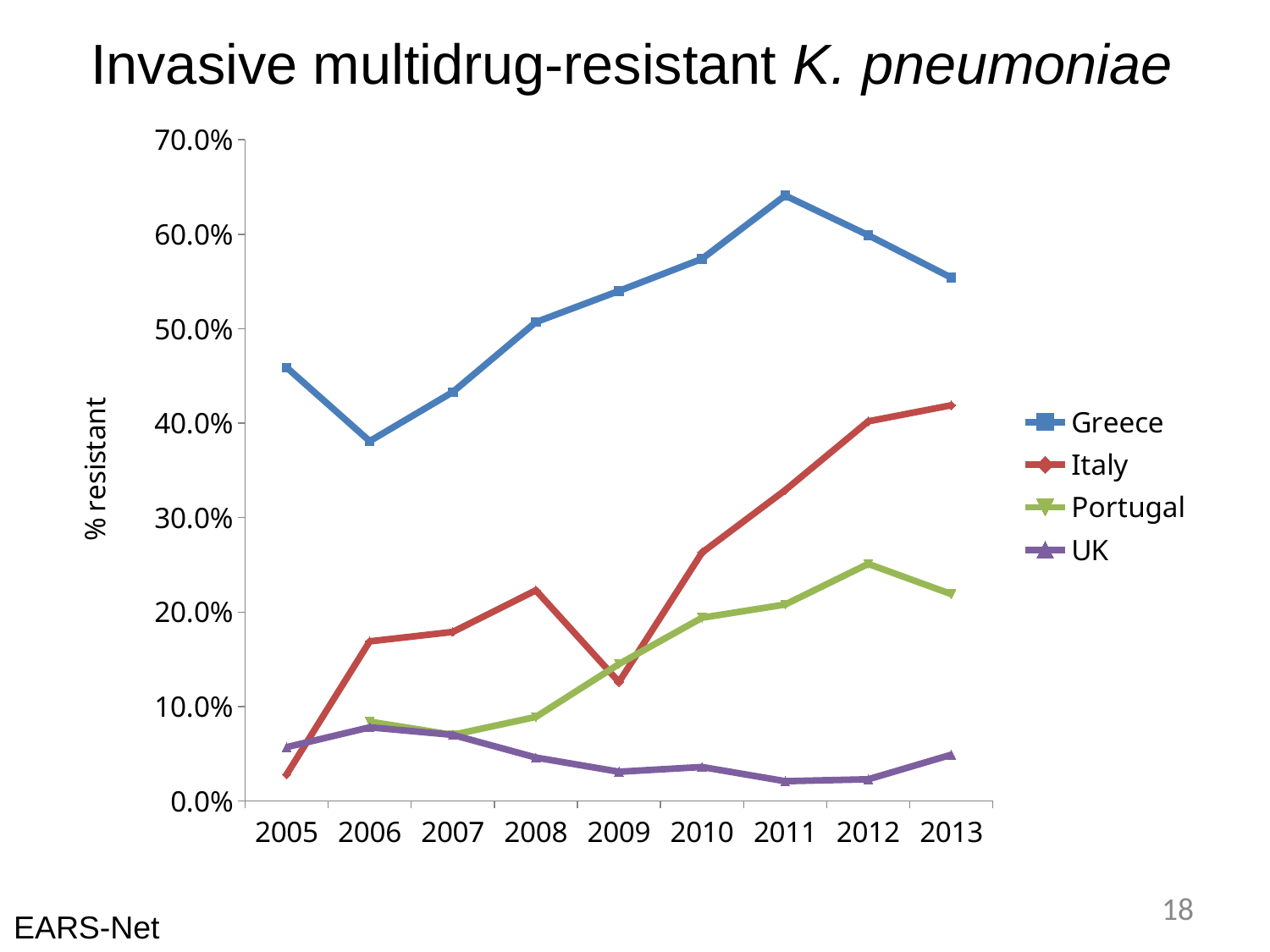
In 2013, which is larger: the value for Italy or the value for Portugal? Italy What kind of chart is shown on the slide? line chart Which country has the highest % resistant in 2013? Greece Is the value for Portugal in 2012 greater or less than 30.0%? less Is the value for Greece in 2011 greater or less than 60.0%? greater Which country has the lowest % resistant in 2011? UK How many series does the legend list? 4 Is the value for Italy in 2012 greater or less than 30.0%? greater How many years are shown on the x axis? 9 In which year does the Greece line reach its highest point? 2011 Does the Italy line rise or fall from 2009 to 2013? rise